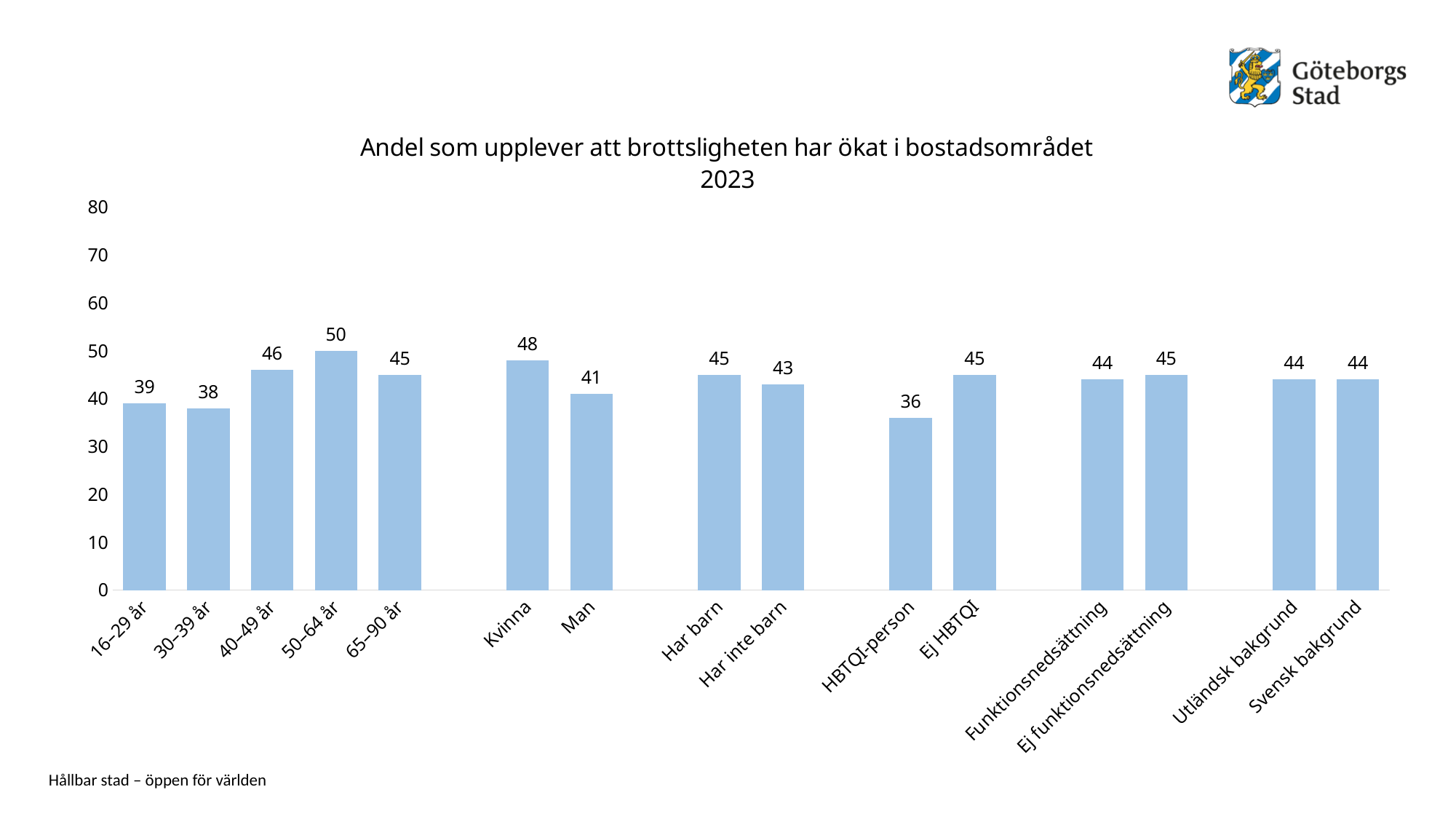
What is the difference between the values for Ej HBTQI and HBTQI-person? 9 What kind of chart is this? bar chart Which category has the lowest value? HBTQI-person Which category has the highest value? 50–64 år How many categories are shown on the x axis? 15 Which is larger, the value for Har barn or the value for Har inte barn? Har barn What year is shown in the chart title? 2023 What is the value for Kvinna? 48 What is the difference between the values for Kvinna and Man? 7 What is the value for 50–64 år? 50 Is the value for 30–39 år greater or less than 40? less What is the value for HBTQI-person? 36